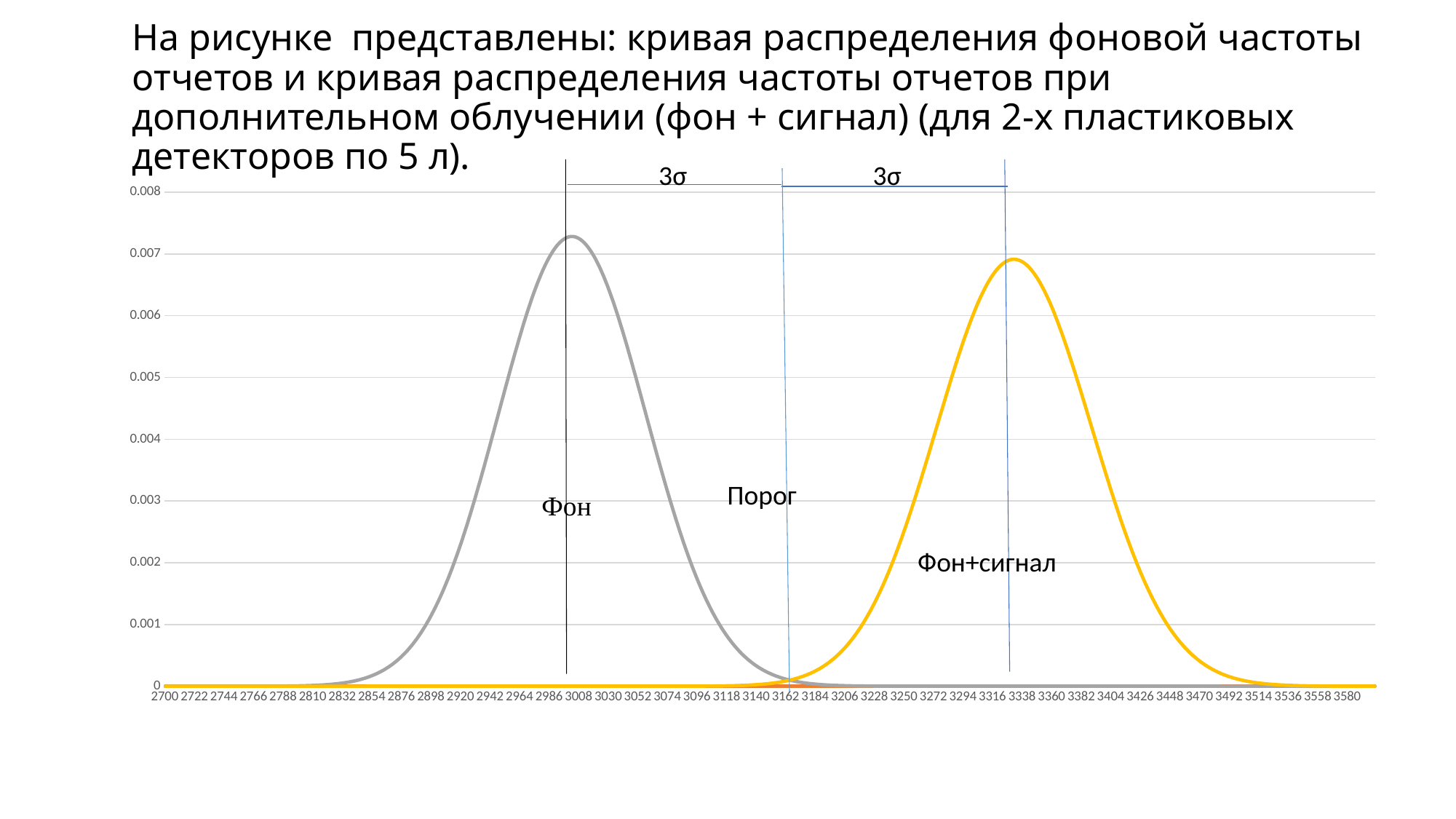
What is the label of the vertical line drawn between the two curves? Порог What kind of chart is shown on the slide? Line chart How many curves are plotted on the chart? 2 Which curve is located further to the right along the x axis, Фон or Фон+сигнал? Фон+сигнал Which curve has the higher peak, Фон or Фон+сигнал? Фон Is the peak value of the Фон curve greater or less than 0.007? greater Is the value of the Фон curve at x = 3338 greater or less than 0.001? less What is the highest value shown on the y axis? 0.008 Is the peak value of the Фон+сигнал curve greater or less than 0.006? greater What colour is the Фон+сигнал curve? Yellow